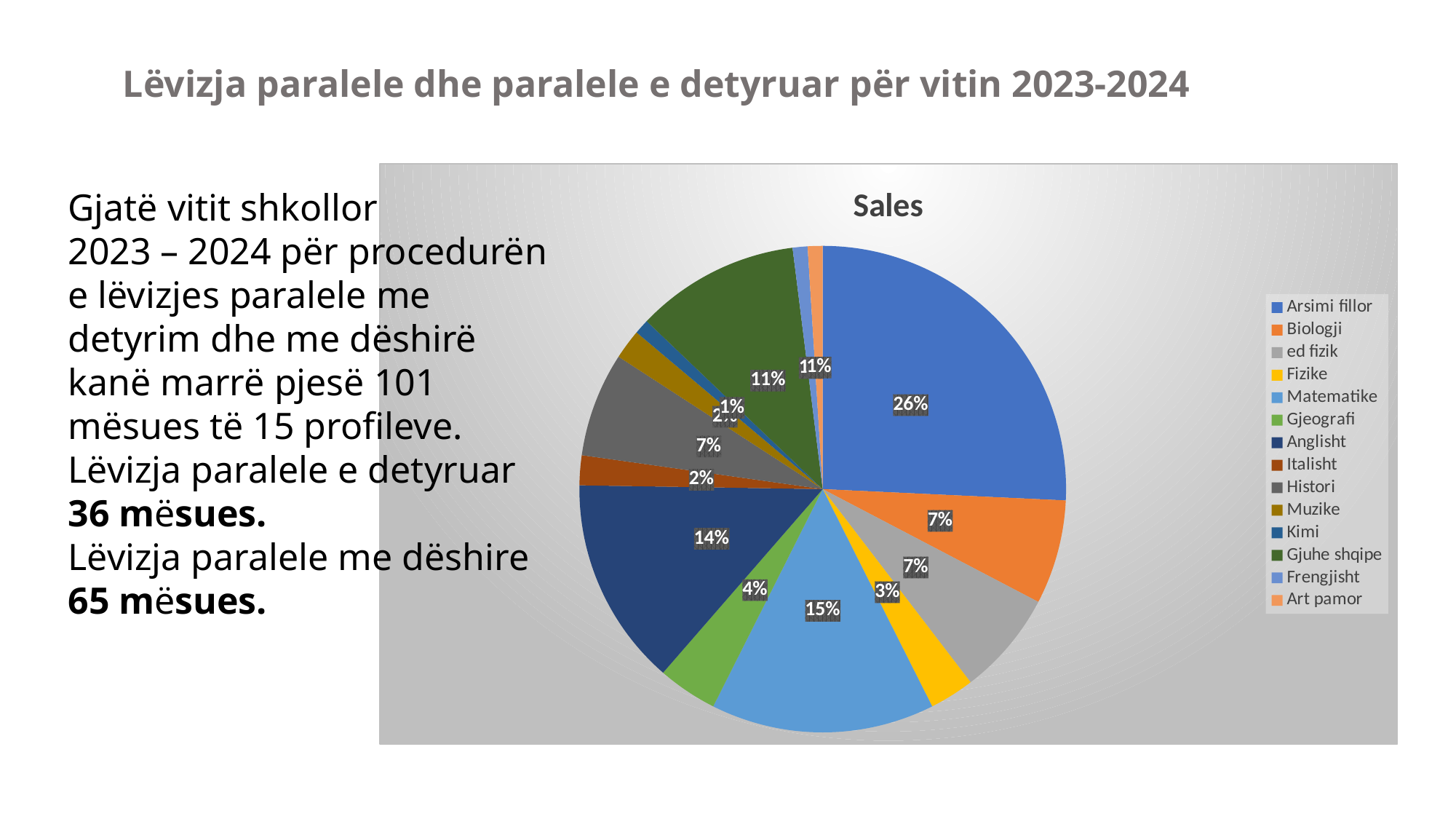
What share of the pie does Fizike have? 3% Which is larger, the slice for Matematike or the slice for Anglisht? Matematike What share of the pie does Biologji have? 7% What share of the pie does Gjeografi have? 4% What is the difference in percentage points between the Arsimi fillor slice and the Matematike slice? 11 Which category has the largest slice of the pie? Arsimi fillor What share of the pie does Anglisht have? 14% What share of the pie does Arsimi fillor have? 26% What share of the pie does Matematike have? 15% What kind of chart is shown on the slide? pie chart How many categories does the legend list? 14 What is the title of the chart? Sales